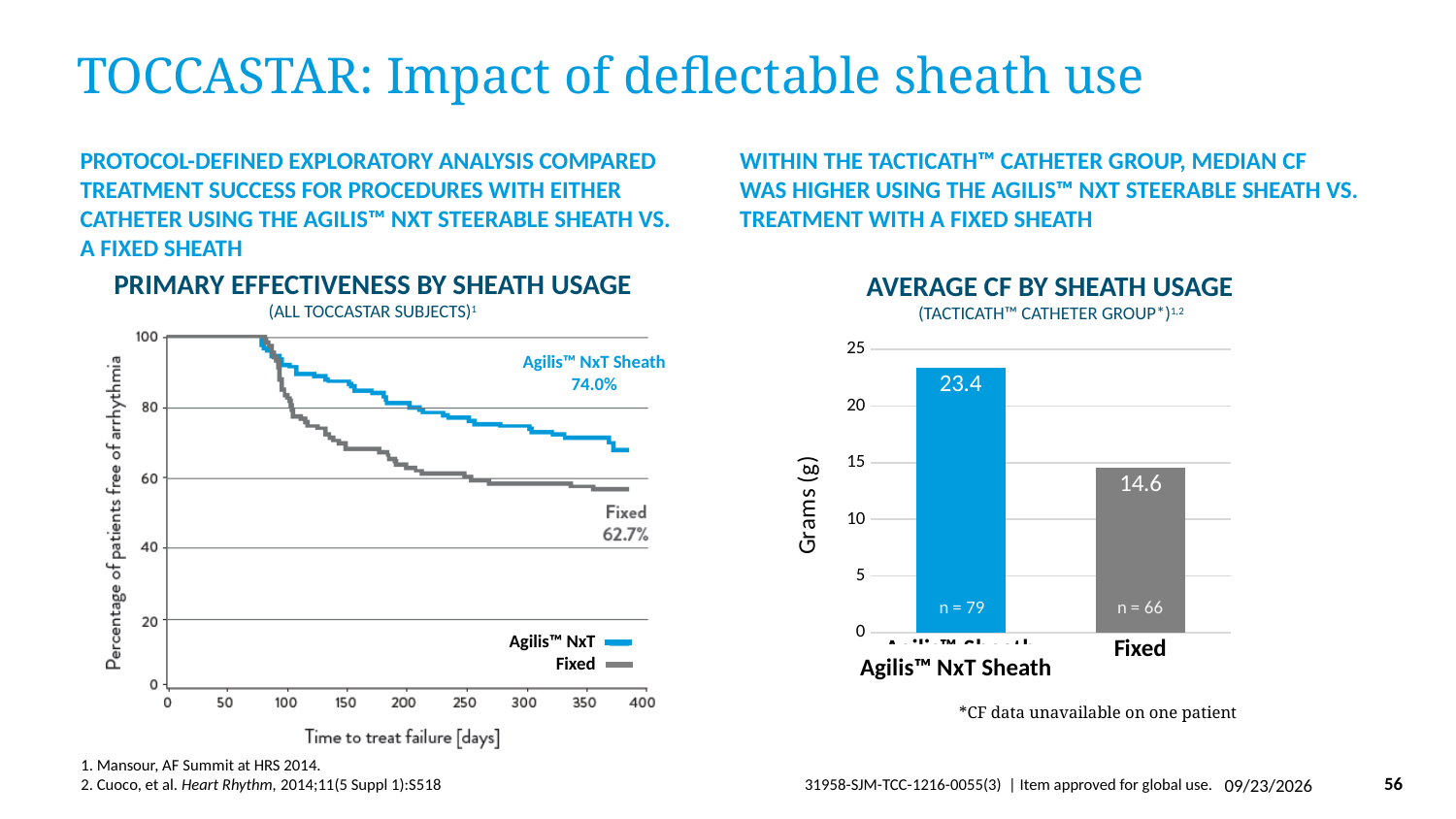
In the 'Average CF by Sheath Usage' bar chart, what is the label on the vertical axis? Grams (g) In the 'Average CF by Sheath Usage' bar chart, what is the sample size (n) shown for the Agilis™ NxT Sheath bar? n = 79 In the 'Primary Effectiveness by Sheath Usage' chart, how many series does the legend list? 2 In the 'Primary Effectiveness by Sheath Usage' chart, what final percentage is labelled for the Agilis™ NxT Sheath curve? 74.0% In the 'Average CF by Sheath Usage' bar chart, what is the value for the Agilis™ NxT Sheath? 23.4 In the 'Average CF by Sheath Usage' bar chart, what is the value for the Fixed sheath? 14.6 In the 'Primary Effectiveness by Sheath Usage' chart, what final percentage is labelled for the Fixed curve? 62.7% In the 'Average CF by Sheath Usage' bar chart, how many bars are plotted? 2 In the 'Primary Effectiveness by Sheath Usage' chart, do the curves rise or fall as time to treat failure increases? Fall In the 'Average CF by Sheath Usage' bar chart, what is the difference between the Agilis™ NxT Sheath value and the Fixed value? 8.8 In the 'Average CF by Sheath Usage' bar chart, which category has the higher value? Agilis™ NxT Sheath What kind of chart is 'Average CF by Sheath Usage'? Bar chart